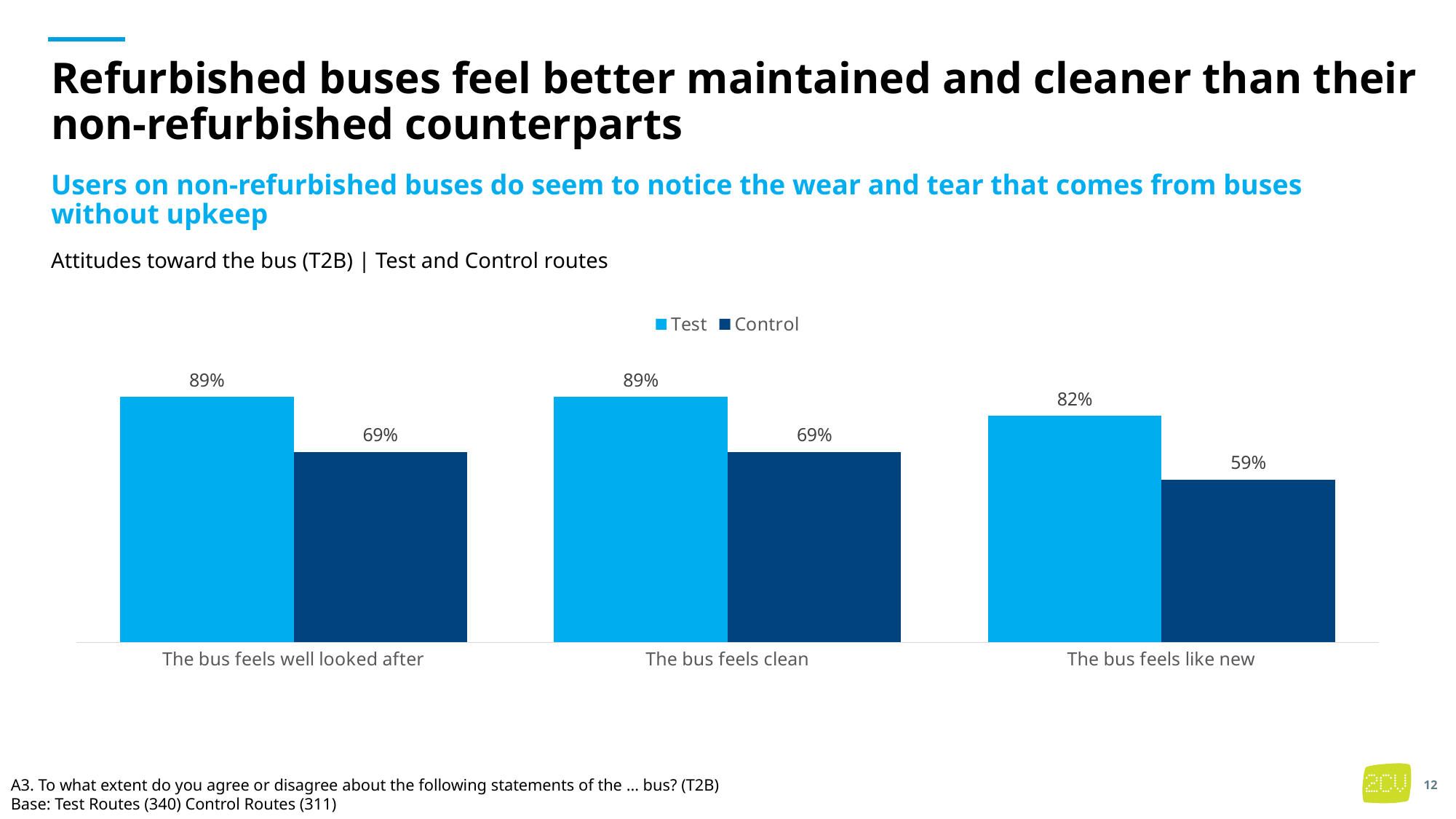
How many categories are shown on the x axis? 3 How many series does the legend list? 2 What is the Test value for "The bus feels like new"? 82% What is the difference between the Test and Control values for "The bus feels like new"? 23 percentage points What is the Test value for "The bus feels well looked after"? 89% What kind of chart is shown on the slide? Bar chart What is the Control value for "The bus feels like new"? 59% What is the difference between the Test and Control values for "The bus feels well looked after"? 20 percentage points Which category has the lowest Test value? The bus feels like new Which is larger for "The bus feels clean": the Test value or the Control value? Test Which category has the lowest Control value? The bus feels like new What is the Control value for "The bus feels clean"? 69%